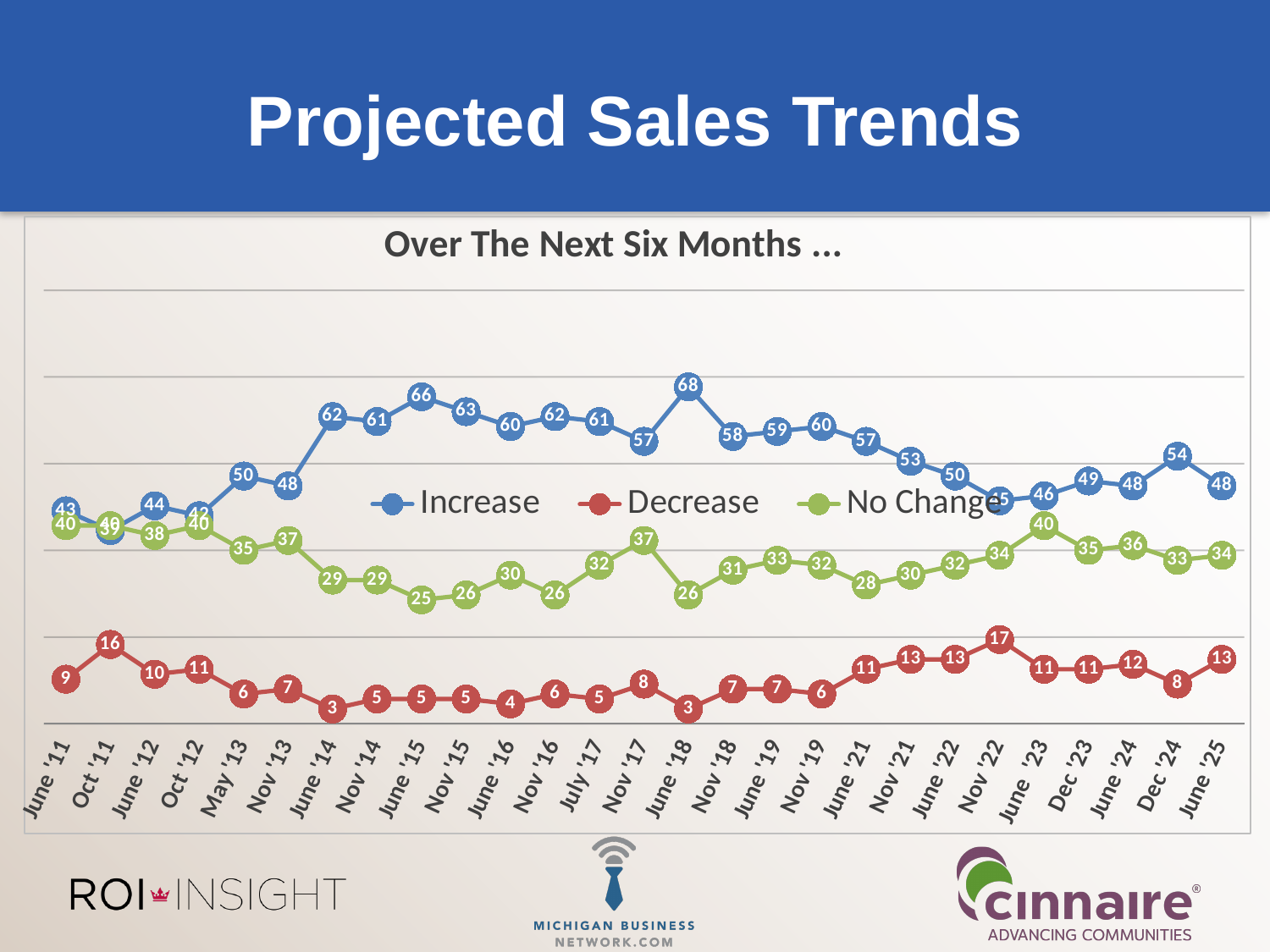
In which period does the Decrease series reach its highest value? Nov '22 In which period does the Increase series reach its highest value? June '18 What is the Increase value for June '18? 68 In which period does the No Change series reach its lowest value? June '15 What is the Decrease value for Nov '22? 17 Which is larger: the Increase value for June '15 or the Increase value for Nov '17? June '15 What is the difference between the Increase and No Change values for June '25? 14 Does the Decrease series rise or fall from Nov '19 to Nov '22? rise What kind of chart is shown on the slide? line chart How many time periods are shown on the x axis? 27 What is the Decrease value for June '11? 9 How many series does the legend list? 3